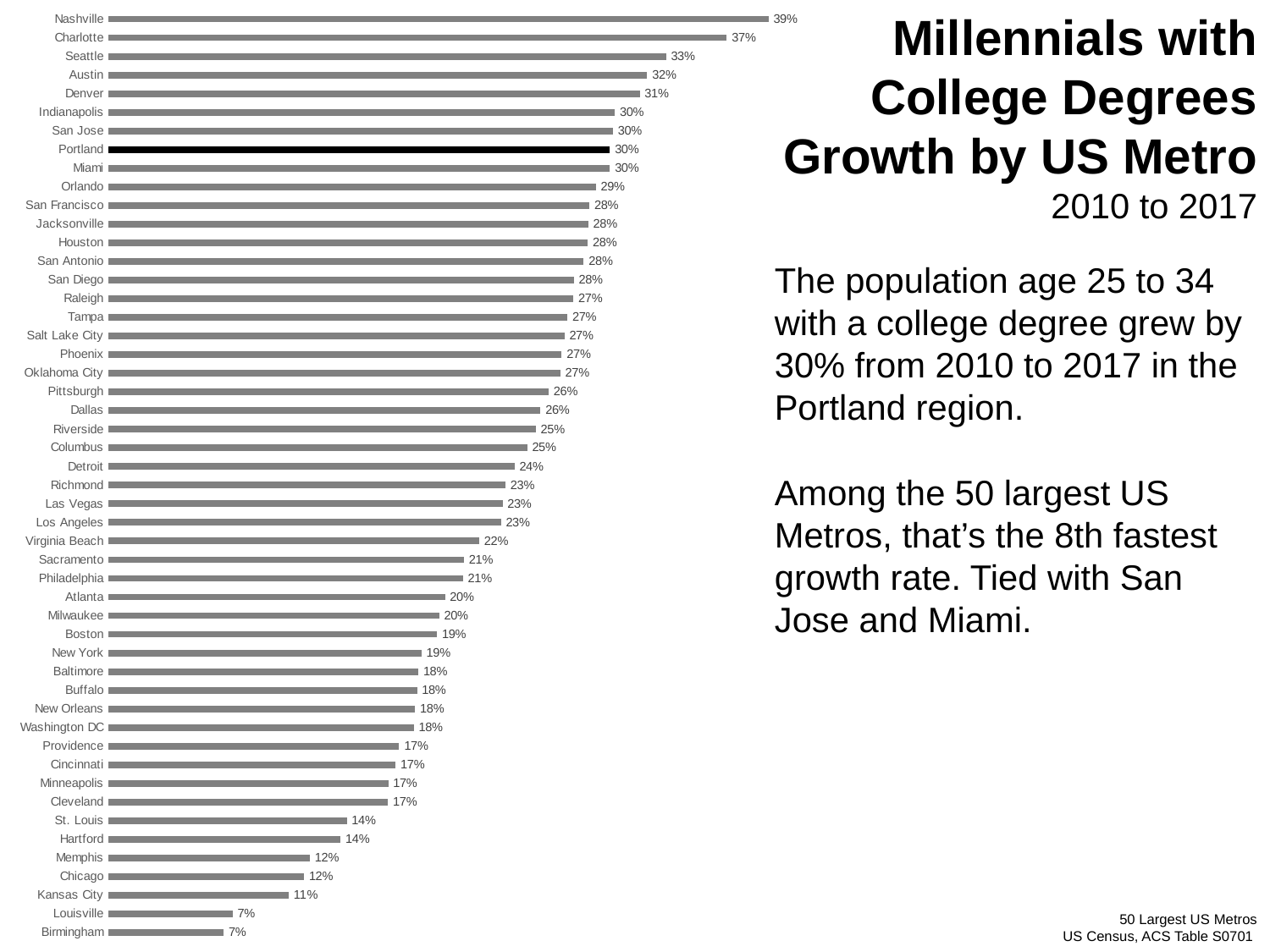
Which metro's bar is drawn in black rather than gray? Portland What is the difference between the values for Nashville and Portland? 9 percentage points Which has a larger value, Atlanta or Boston? Atlanta Which metro has the highest value in the chart? Nashville What is the value shown for Nashville? 39% What is the value shown for Washington DC? 18% What is the lowest value shown in the chart? 7% Which has a larger value, Seattle or Denver? Seattle What is the value shown for Kansas City? 11% How many metros are shown in the chart? 50 What is the value shown for Portland? 30% What kind of chart is shown on the slide? Bar chart